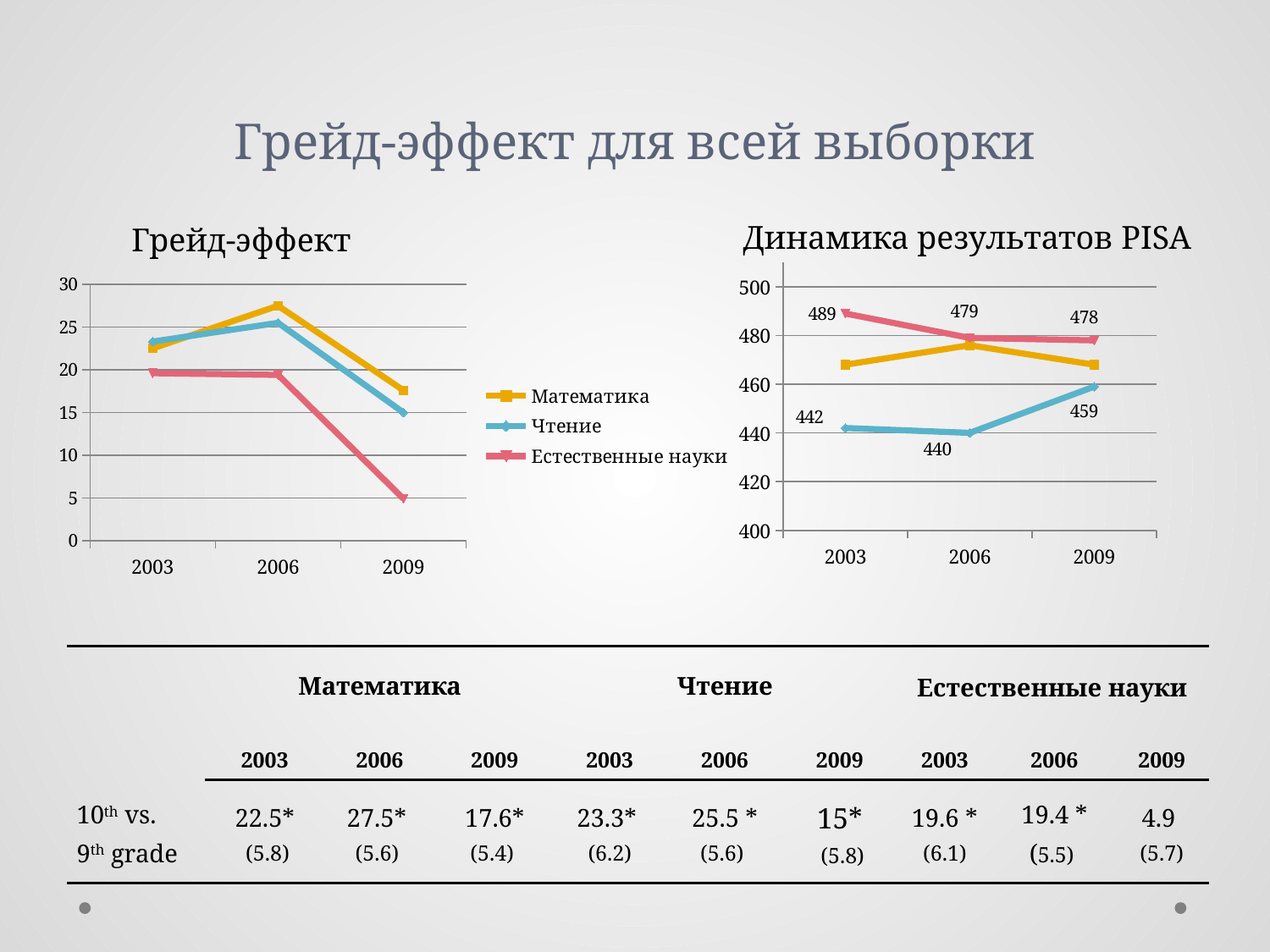
In the chart titled 'Динамика результатов PISA', what is the value for Чтение in 2009? 459 How many years are shown on the x axis of the chart titled 'Грейд-эффект'? 3 What kind of chart is the chart titled 'Грейд-эффект'? line chart In the chart titled 'Динамика результатов PISA', which is larger for Чтение: the 2003 value or the 2006 value? 2003 In the chart titled 'Динамика результатов PISA', what is the difference between the Естественные науки values for 2003 and 2009? 11 In the chart titled 'Грейд-эффект', is the value for Математика in 2006 greater or less than 25? greater In the chart titled 'Динамика результатов PISA', does the Чтение line rise or fall from 2006 to 2009? rises How many series does the legend of the chart titled 'Грейд-эффект' list? 3 In the chart titled 'Динамика результатов PISA', in which year is the Чтение value lowest? 2006 In the chart titled 'Грейд-эффект', which series has the highest value in 2006? Математика In the chart titled 'Динамика результатов PISA', what is the value for Естественные науки in 2003? 489 In the chart titled 'Грейд-эффект', is the value for Естественные науки in 2009 greater or less than 10? less